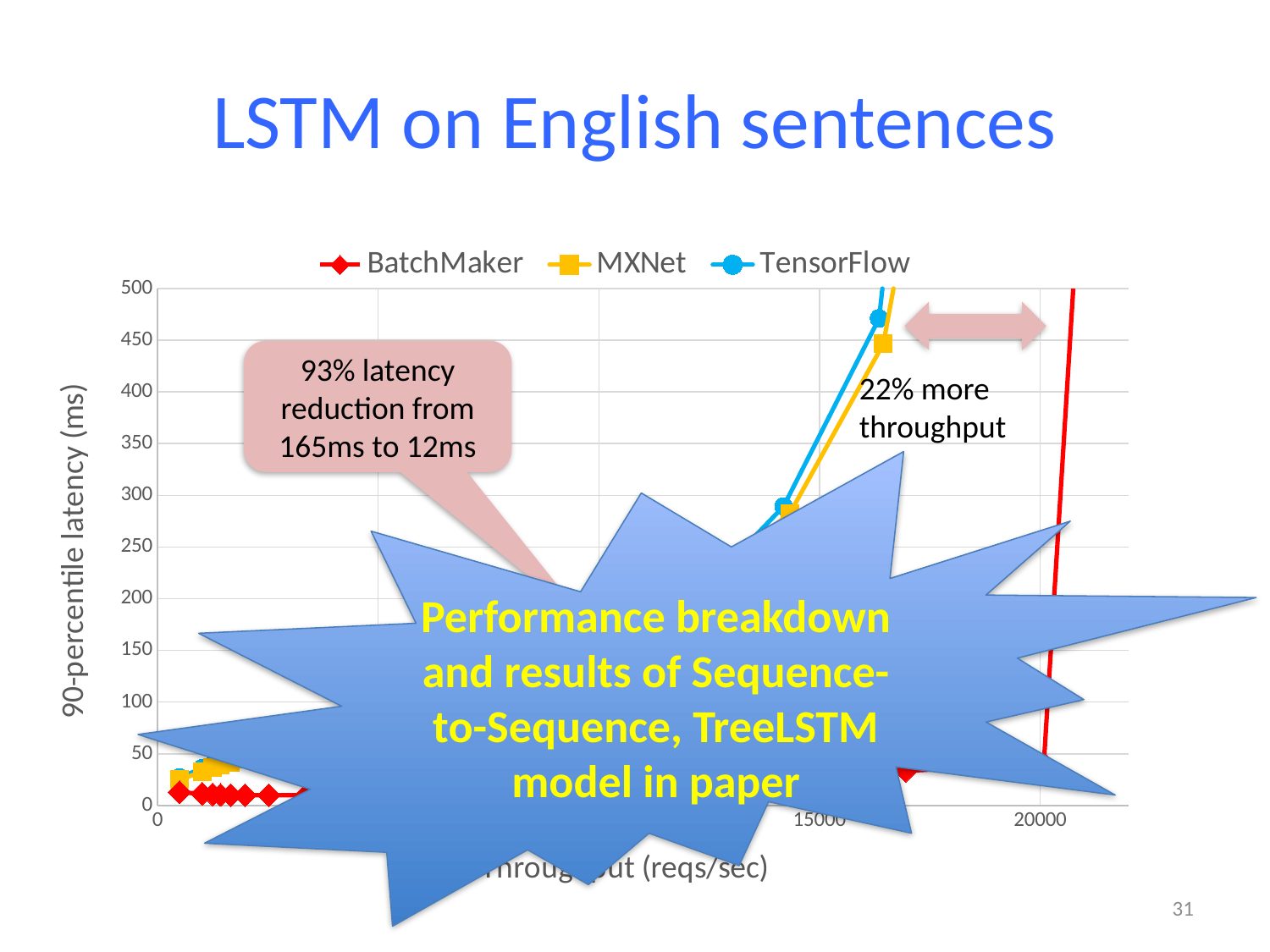
Which series reaches the highest throughput before its latency rises sharply? BatchMaker How many series does the legend list? 3 What is the label of the y axis? 90-percentile latency (ms) Does the TensorFlow latency rise or fall as throughput increases? rise According to the callout on the slide, what latency reduction does BatchMaker achieve? 93% latency reduction from 165ms to 12ms What kind of chart is shown on the slide? line chart According to the annotation on the slide, how much more throughput does BatchMaker achieve? 22% more throughput Is the BatchMaker latency at a throughput of about 2000 reqs/sec greater or less than 50 ms? less What are the three series named in the legend? BatchMaker, MXNet, TensorFlow At low throughput (around 1000-2000 reqs/sec), which series has the lower latency, BatchMaker or MXNet? BatchMaker Is the MXNet latency at a throughput of about 17000 reqs/sec greater or less than 400 ms? greater Is the TensorFlow latency at a throughput of about 15000 reqs/sec greater or less than 250 ms? greater